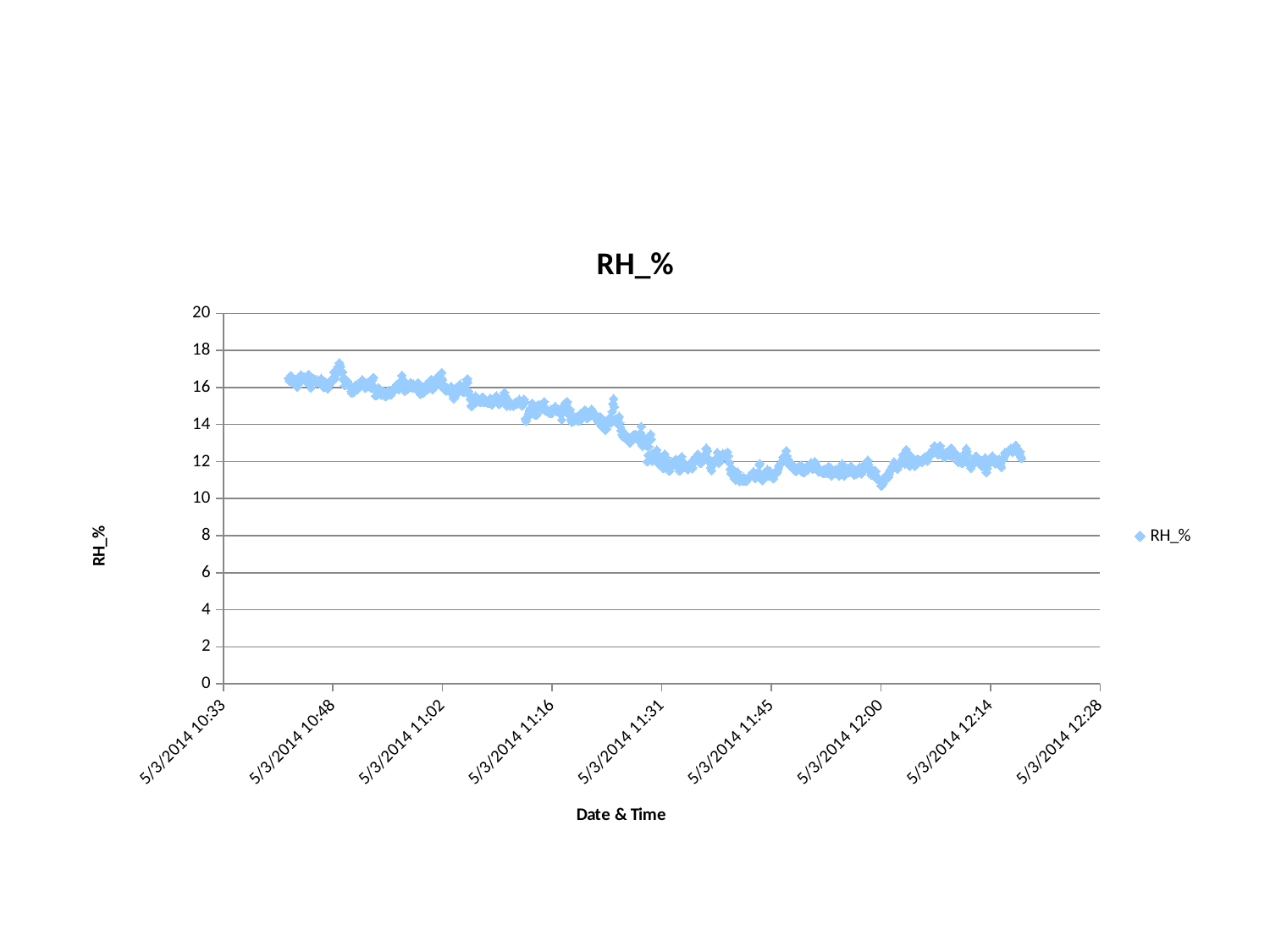
Is the RH_% value at 5/3/2014 10:48 greater or less than 14? greater What is the label on the x axis of the chart? Date & Time What is the title of the chart? RH_% Do the RH_% values generally rise or fall from left to right along the x axis? fall Is the RH_% value at 5/3/2014 12:00 greater or less than 14? less What kind of chart is shown on the slide? scatter chart How many series does the legend list? 1 Is the RH_% value at 5/3/2014 11:31 greater or less than 16? less Which of the two times has the higher RH_% value: 5/3/2014 10:48 or 5/3/2014 12:00? 5/3/2014 10:48